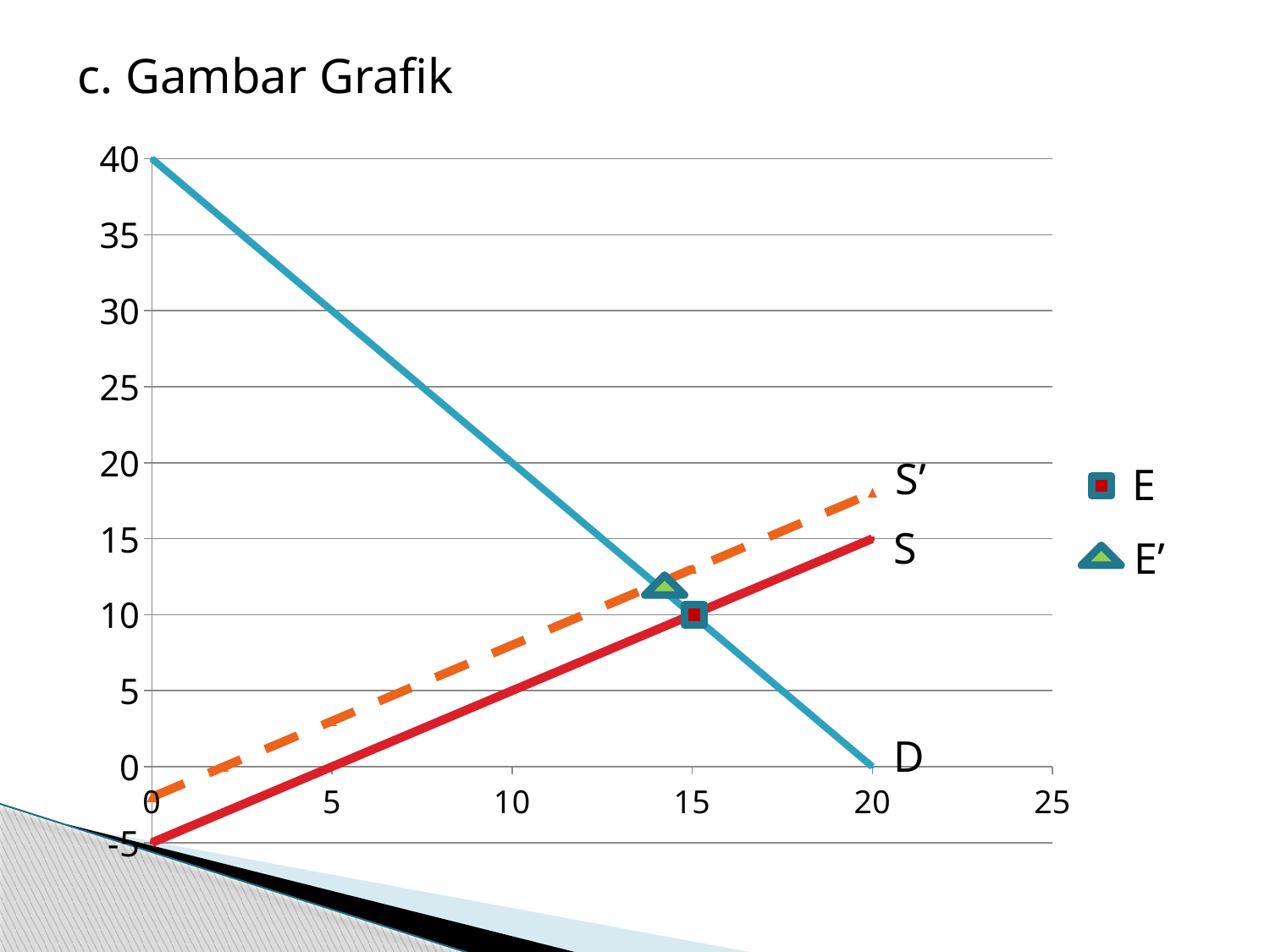
At what x and y coordinates is point E plotted? x = 15, y = 10 How many entries does the legend list? 2 What is the title of the slide above the chart? c. Gambar Grafik Is the y value of point E' greater or less than 10? greater Does line D rise or fall as x increases? fall At x = 20, which line is higher, S or S'? S' What kind of chart is shown on the slide? line chart What is the value of line S at x = 0? -5 What is the value of line S at x = 20? 15 What are the two entries listed in the legend? E and E' What is the value of line D where it meets the vertical axis at x = 0? 40 What is the value of line D at x = 20? 0